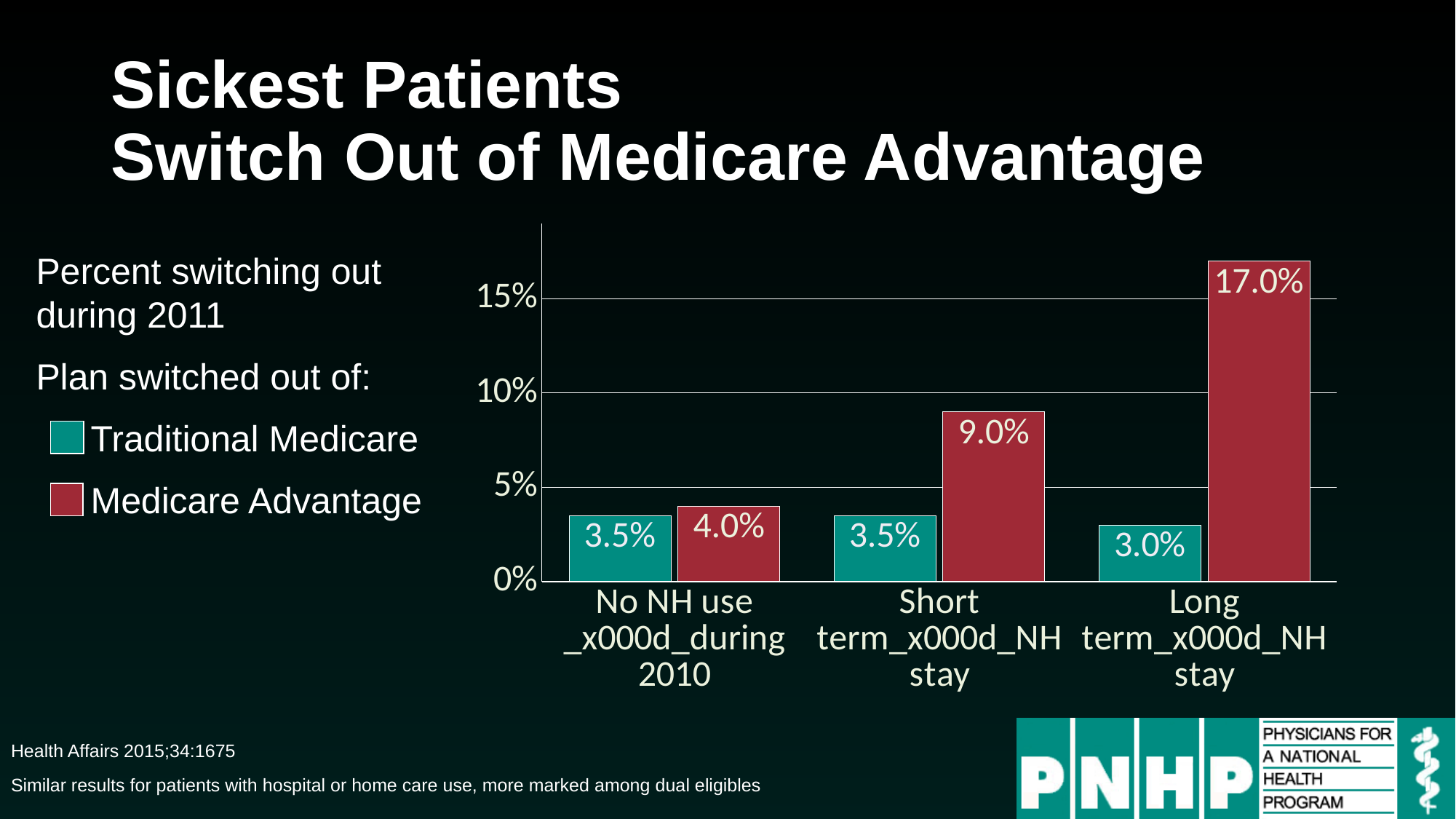
What is the difference between the Medicare Advantage values for Long term NH stay and Short term NH stay? 8.0% What is the Traditional Medicare value for the Long term NH stay category? 3.0% Which is larger for the Long term NH stay category: Traditional Medicare or Medicare Advantage? Medicare Advantage Which category has the highest Medicare Advantage value? Long term NH stay What is the difference between the Medicare Advantage and Traditional Medicare values for the Short term NH stay category? 5.5% How many series does the legend list? 2 What is the Medicare Advantage value for the No NH use during 2010 category? 4.0% How many categories are shown on the x axis? 3 What kind of chart is shown on the slide? Bar chart What is the Traditional Medicare value for the Short term NH stay category? 3.5% Which category has the lowest Traditional Medicare value? Long term NH stay What is the Medicare Advantage value for the Long term NH stay category? 17.0%